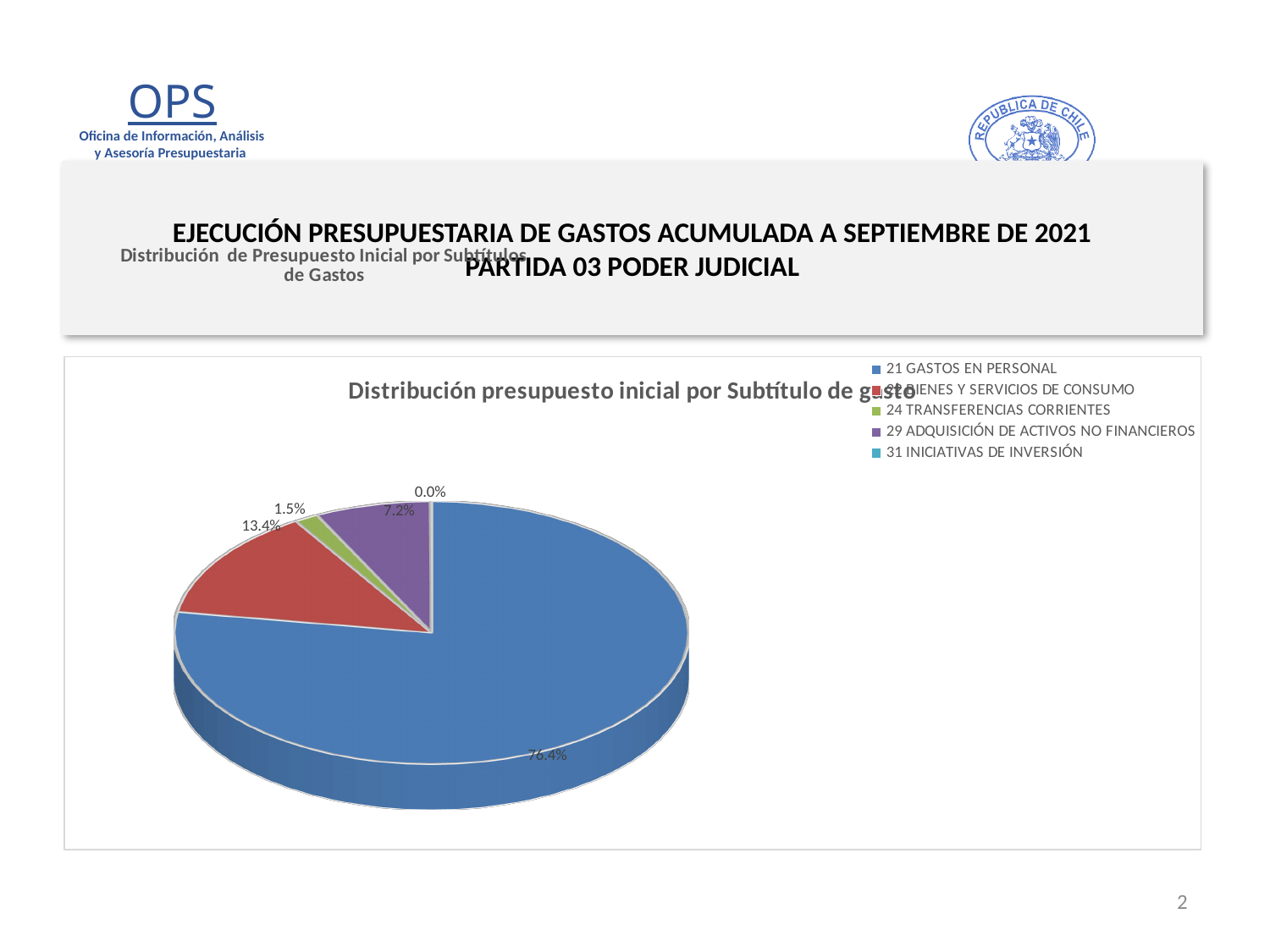
How many categories does the legend list? 5 What share of the pie does 21 GASTOS EN PERSONAL represent? 76.4% What kind of chart is shown on the slide? Pie chart Which slice is larger: 29 ADQUISICIÓN DE ACTIVOS NO FINANCIEROS or 24 TRANSFERENCIAS CORRIENTES? 29 ADQUISICIÓN DE ACTIVOS NO FINANCIEROS What share of the pie does 29 ADQUISICIÓN DE ACTIVOS NO FINANCIEROS represent? 7.2% What colour is the largest slice of the pie? Blue Which category has the largest slice of the pie? 21 GASTOS EN PERSONAL What share of the pie does 31 INICIATIVAS DE INVERSIÓN represent? 0.0% What is the title of the chart? Distribución presupuesto inicial por Subtítulo de gasto What share of the pie does 24 TRANSFERENCIAS CORRIENTES represent? 1.5% Which category has the smallest slice of the pie? 31 INICIATIVAS DE INVERSIÓN What is the difference in percentage points between the 21 GASTOS EN PERSONAL slice and the 13.4% slice? 63.0 percentage points